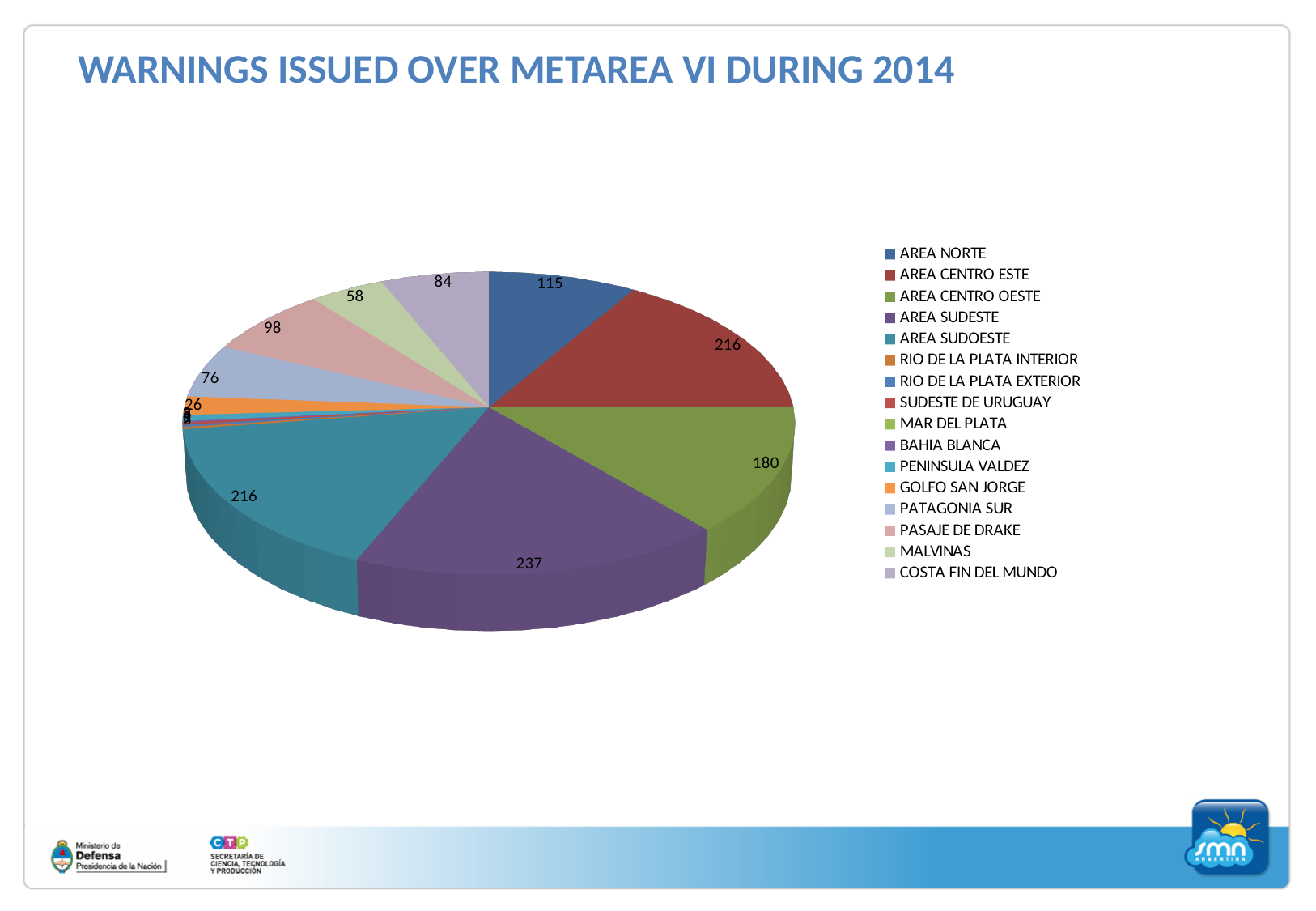
Which is larger, the value for PATAGONIA SUR or the value for GOLFO SAN JORGE? PATAGONIA SUR What is the value shown for AREA NORTE? 115 What is the difference between the values for PASAJE DE DRAKE and MALVINAS? 40 What is the value shown for PASAJE DE DRAKE? 98 What is the difference between the values for AREA SUDESTE and AREA SUDOESTE? 21 What is the value shown for MALVINAS? 58 What kind of chart is shown on the slide? pie chart What is the value shown for AREA CENTRO OESTE? 180 What is the value shown for COSTA FIN DEL MUNDO? 84 How many warnings were issued over AREA SUDESTE? 237 Which area has the largest slice of the pie? AREA SUDESTE How many categories does the legend list? 16